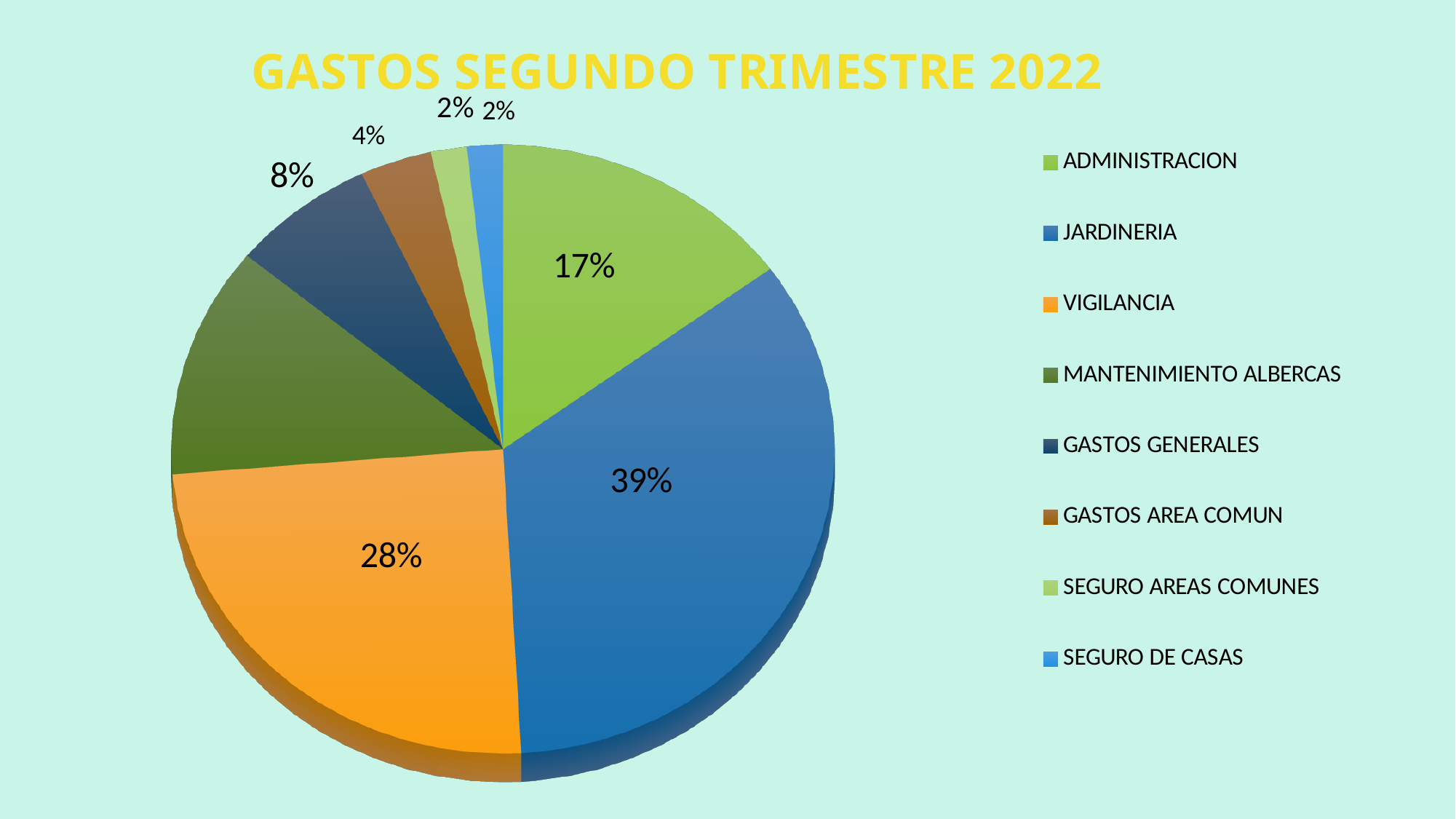
What kind of chart is shown on the slide? Pie chart Which category has the largest slice of the pie? JARDINERIA What percentage is shown for SEGURO DE CASAS? 2% What is the difference in percentage points between JARDINERIA and VIGILANCIA? 11 percentage points What is the title of the chart? GASTOS SEGUNDO TRIMESTRE 2022 What percentage is shown for GASTOS AREA COMUN? 4% What percentage is shown for VIGILANCIA? 28% What percentage is shown for ADMINISTRACION? 17% Which is larger, the share for VIGILANCIA or the share for ADMINISTRACION? VIGILANCIA How many categories does the legend list? 8 What is the combined share of ADMINISTRACION, JARDINERIA and VIGILANCIA? 84% What share of the pie does JARDINERIA represent? 39%